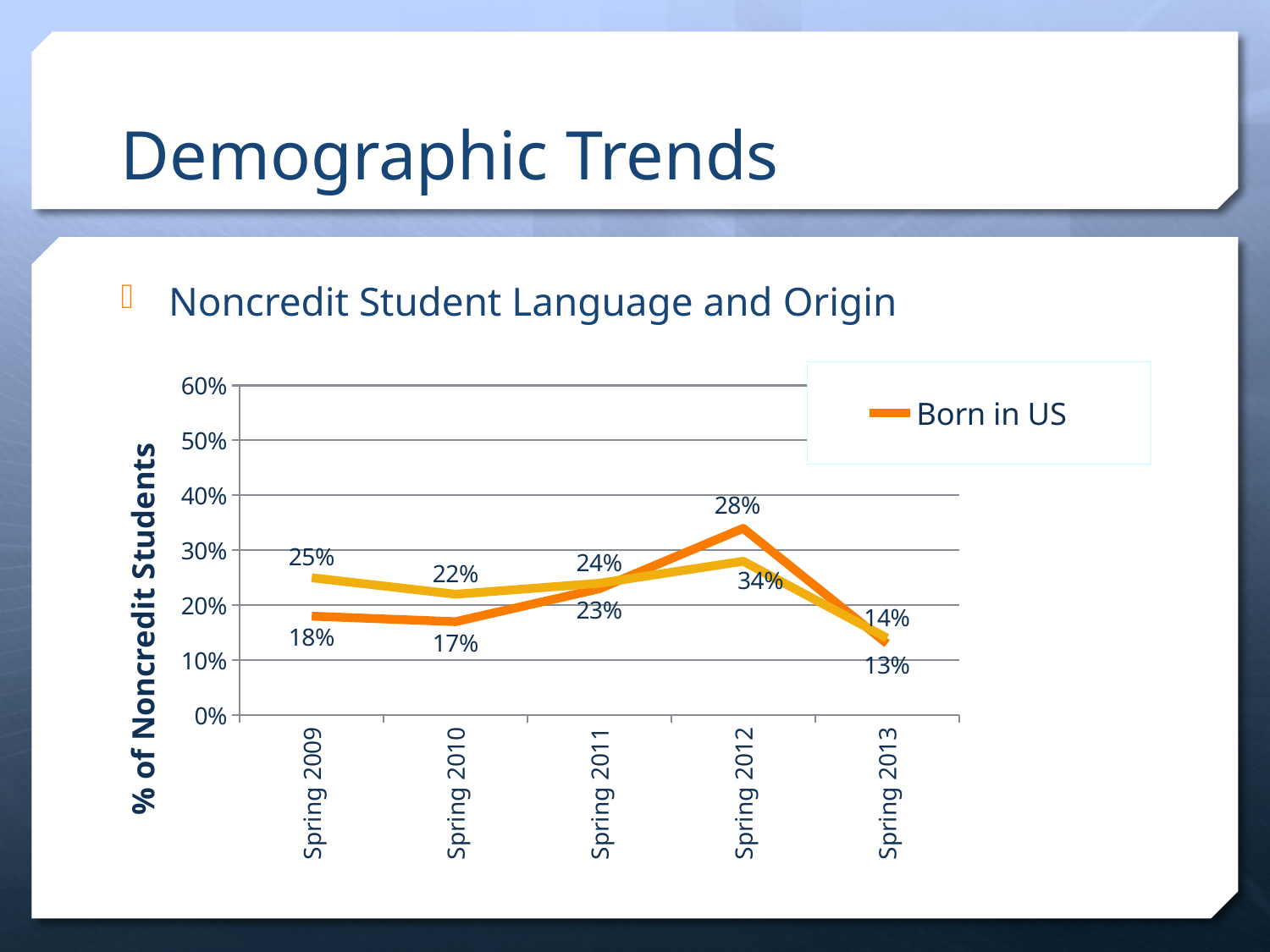
Does the Born in US value rise or fall from Spring 2012 to Spring 2013? fall What is the Born in US value for Spring 2013? 13% What is the Born in US value for Spring 2009? 18% In which term is the Born in US percentage highest? Spring 2012 How many terms are shown on the x axis? 5 What is the Born in US value for Spring 2012? 34% In which term is the Born in US percentage lowest? Spring 2013 Which term has the larger Born in US value, Spring 2010 or Spring 2011? Spring 2011 What is the title of the vertical axis? % of Noncredit Students What kind of chart is shown on the slide? line chart By how many percentage points does the Born in US value in Spring 2012 exceed the value in Spring 2009? 16 Is the Born in US value for Spring 2012 greater or less than 30%? greater